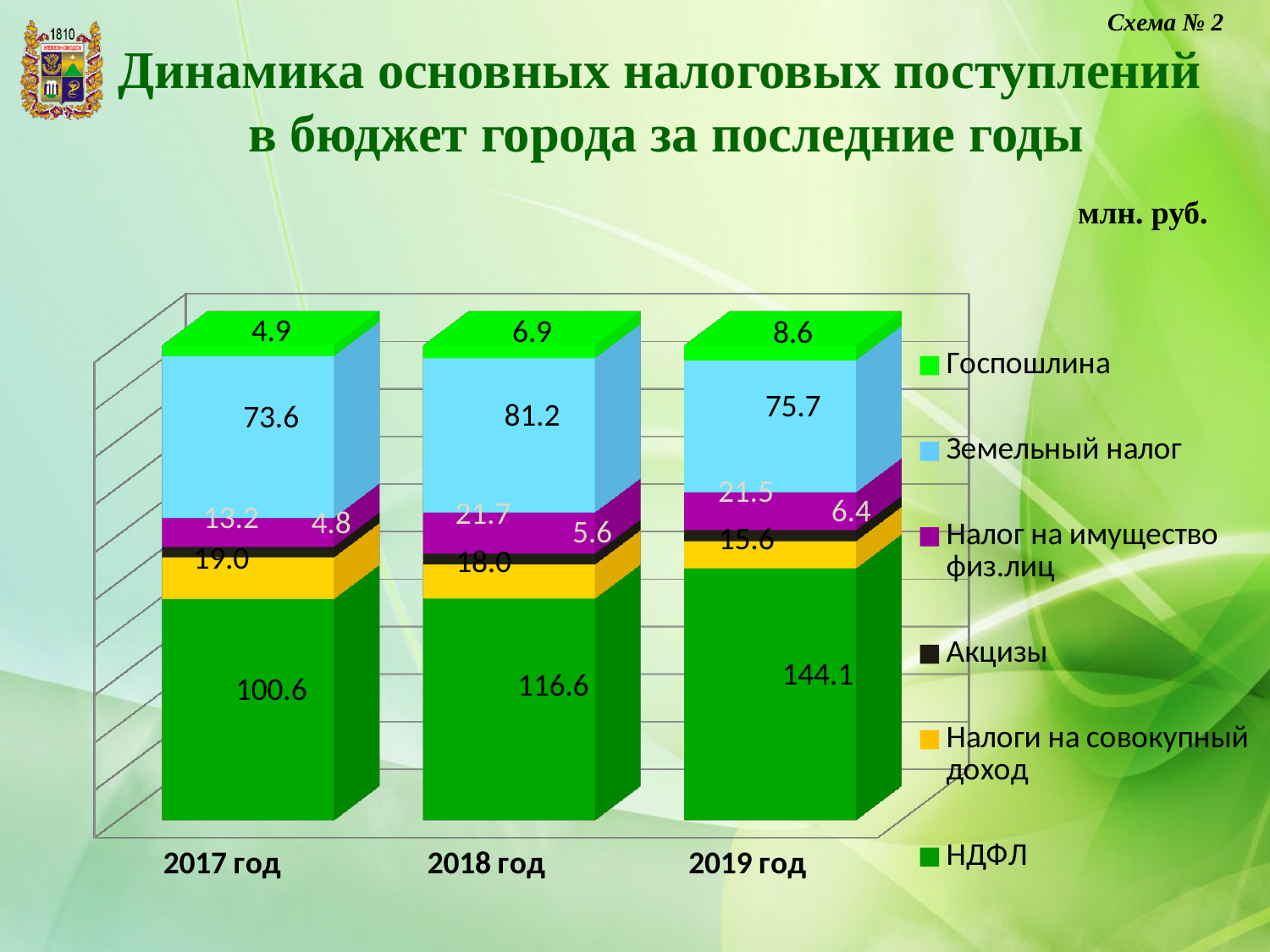
Which is larger: Земельный налог in 2018 год or in 2019 год? 2018 год What is the value of Земельный налог for 2018 год? 81.2 What is the difference between НДФЛ in 2019 год and 2017 год? 43.5 What is the value of НДФЛ for 2019 год? 144.1 What type of chart is shown on the slide? Stacked bar chart What is the total of the stacked bar for 2018 год? 250.0 In which year is Налоги на совокупный доход the lowest? 2019 год In which year is НДФЛ the highest? 2019 год How many series does the legend list? 6 What is the value of Госпошлина for 2017 год? 4.9 How many years (categories) are shown on the x axis? 3 What is the value of Акцизы for 2019 год? 6.4